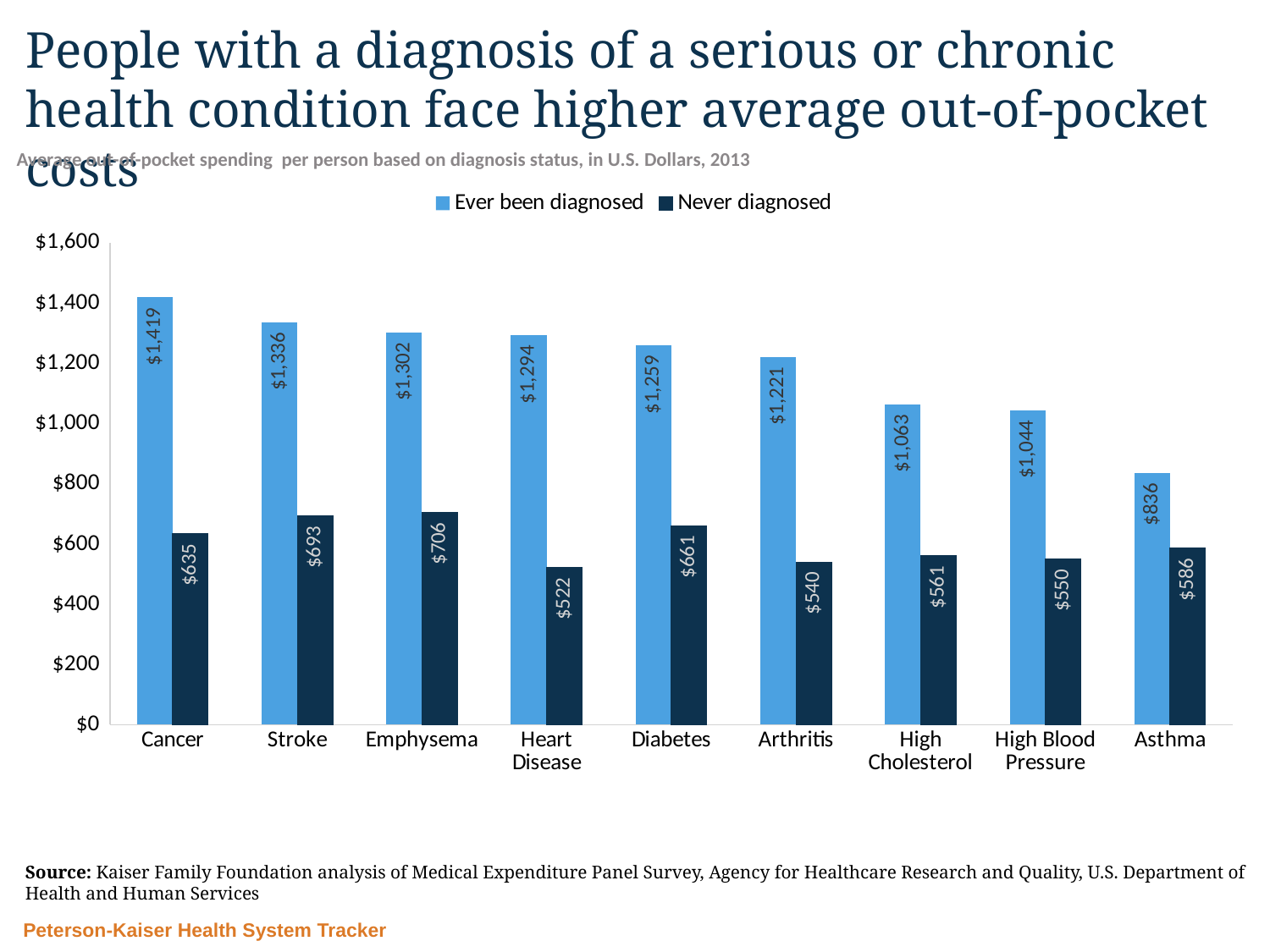
What is the value for the 'Never diagnosed' series for Emphysema? $706 Which is larger: the 'Never diagnosed' value for Stroke or for Arthritis? Stroke How many health conditions are shown on the x axis? 9 How many series does the legend list? 2 Which condition has the highest value in the 'Ever been diagnosed' series? Cancer Is the 'Ever been diagnosed' value for High Cholesterol greater or less than $1,000? greater What kind of chart is shown on the slide? Bar chart Which condition has the lowest value in the 'Ever been diagnosed' series? Asthma What is the average out-of-pocket spending for people ever diagnosed with Cancer? $1,419 Which condition has the lowest value in the 'Never diagnosed' series? Heart Disease What is the difference between the 'Ever been diagnosed' and 'Never diagnosed' values for Diabetes? $598 What is the average out-of-pocket spending for people never diagnosed with Heart Disease? $522